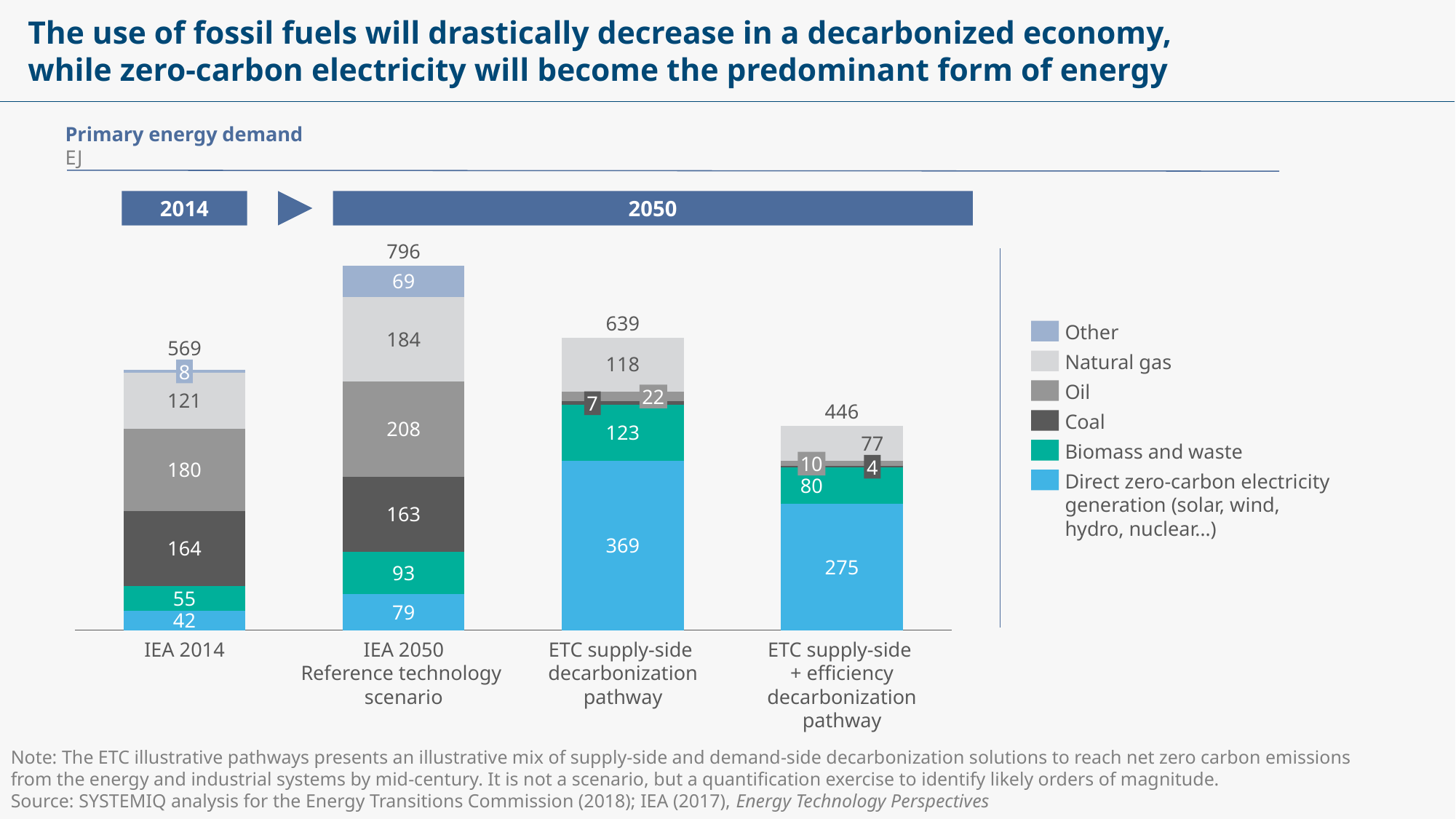
Which scenario has the lowest total primary energy demand? ETC supply-side + efficiency decarbonization pathway What is the value for Direct zero-carbon electricity generation in the ETC supply-side decarbonization pathway bar? 369 How many series does the legend list? 6 What is the value for Oil in the IEA 2050 Reference technology scenario bar? 208 How many scenario bars are shown in the chart? 4 What unit is the primary energy demand measured in on this chart? EJ Which scenario has the highest total primary energy demand? IEA 2050 Reference technology scenario What is the difference in Direct zero-carbon electricity generation between the ETC supply-side decarbonization pathway and the ETC supply-side + efficiency decarbonization pathway? 94 What is the value for Coal in the ETC supply-side + efficiency decarbonization pathway bar? 4 What is the difference between the total for the IEA 2050 Reference technology scenario and the total for the ETC supply-side + efficiency decarbonization pathway? 350 Which has a larger Natural gas value: the ETC supply-side decarbonization pathway or the ETC supply-side + efficiency decarbonization pathway? ETC supply-side decarbonization pathway What is the total of the IEA 2014 stacked bar? 569